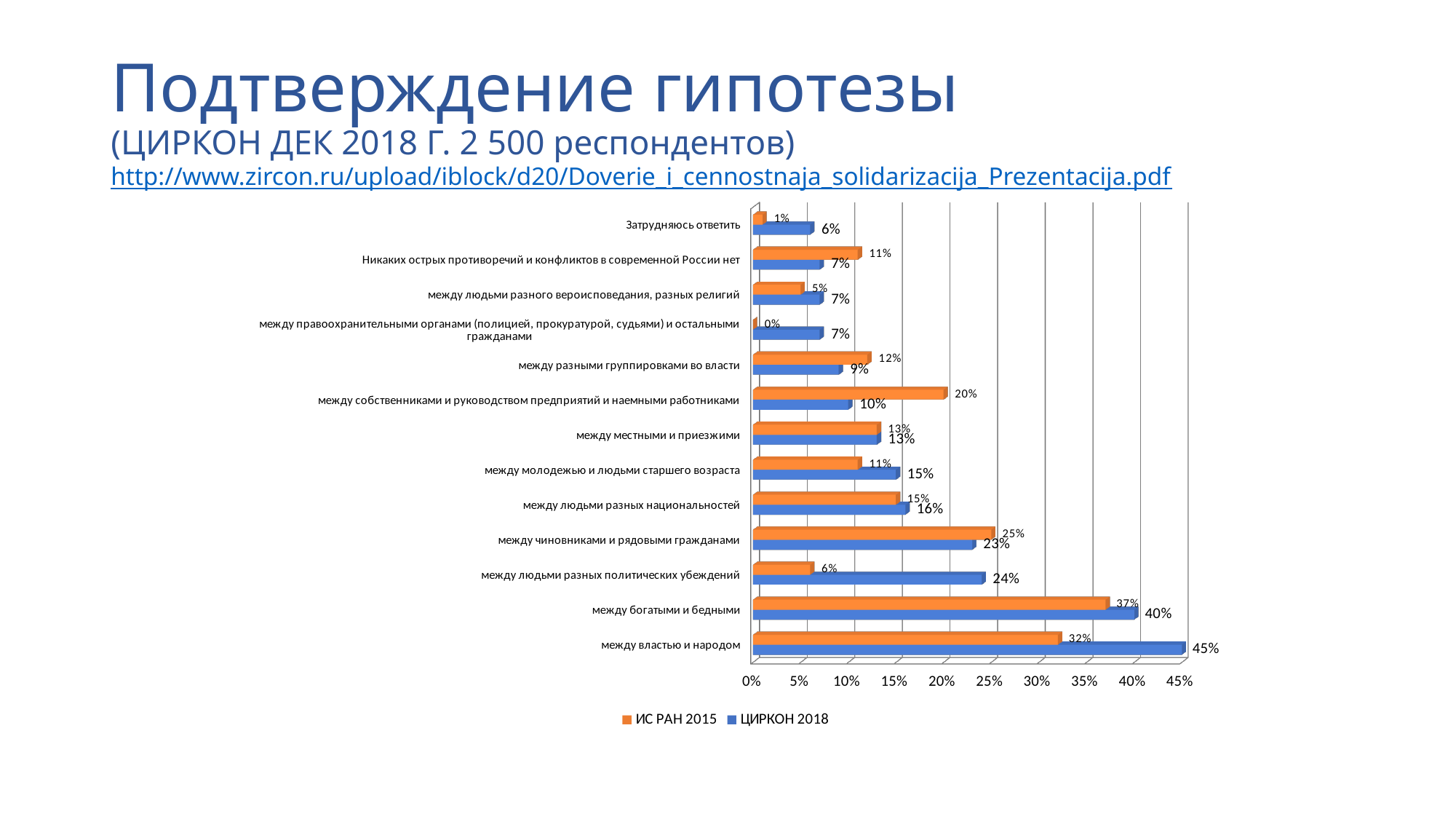
What is the difference between the ЦИРКОН 2018 and ИС РАН 2015 values for "между людьми разных политических убеждений"? 18% How many categories are plotted on the chart? 13 What is the ИС РАН 2015 value for "между людьми разных политических убеждений"? 6% Which category has the lowest ИС РАН 2015 value? между правоохранительными органами (полицией, прокуратурой, судьями) и остальными гражданами Which colour represents the ЦИРКОН 2018 series in the chart? blue What is the ИС РАН 2015 value for "между богатыми и бедными"? 37% What is the difference between the ИС РАН 2015 and ЦИРКОН 2018 values for "между властью и народом"? 13% What is the ЦИРКОН 2018 value for "между властью и народом"? 45% Which category has the highest ЦИРКОН 2018 value? между властью и народом How many series does the legend list? 2 What kind of chart is shown on the slide? bar chart For "между собственниками и руководством предприятий и наемными работниками", which series has the larger value, ИС РАН 2015 or ЦИРКОН 2018? ИС РАН 2015